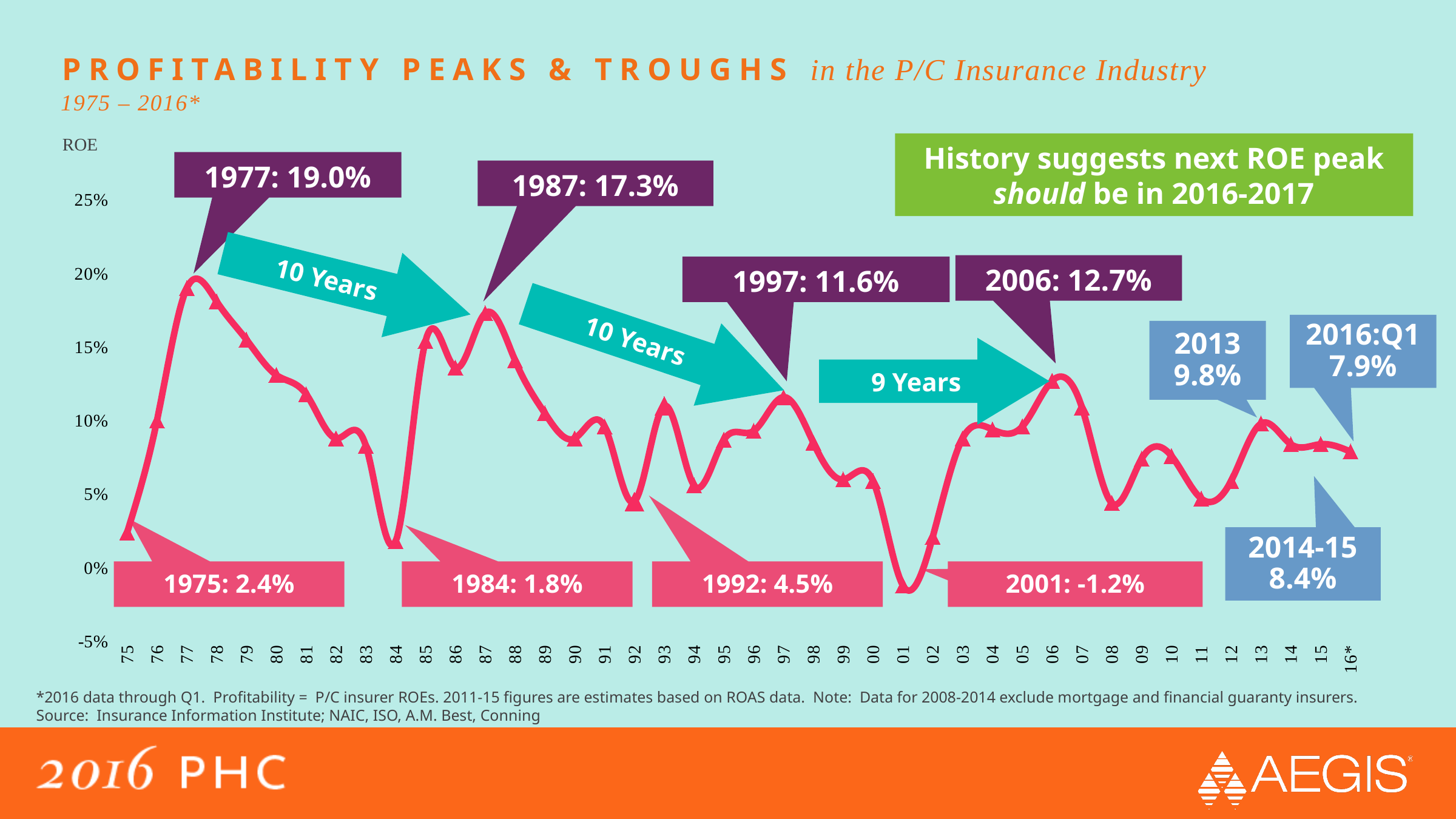
What was the ROE in 1977? 19.0% Which labeled year had the lowest ROE? 2001 What was the ROE in 1992? 4.5% What was the ROE in 2001? -1.2% What was the ROE for 2016:Q1? 7.9% Which labeled year had the highest ROE? 1977 Did the ROE rise or fall from 1977 to 1984? Fall According to the green box, when does history suggest the next ROE peak should be? 2016-2017 Is the ROE value for 2002 greater or less than 5%? less Which was higher, the ROE peak in 1997 or the ROE peak in 2006? 2006 What is the difference between the 1977 ROE peak and the 1987 ROE peak? 1.7 percentage points What kind of chart is shown on the slide? Line chart